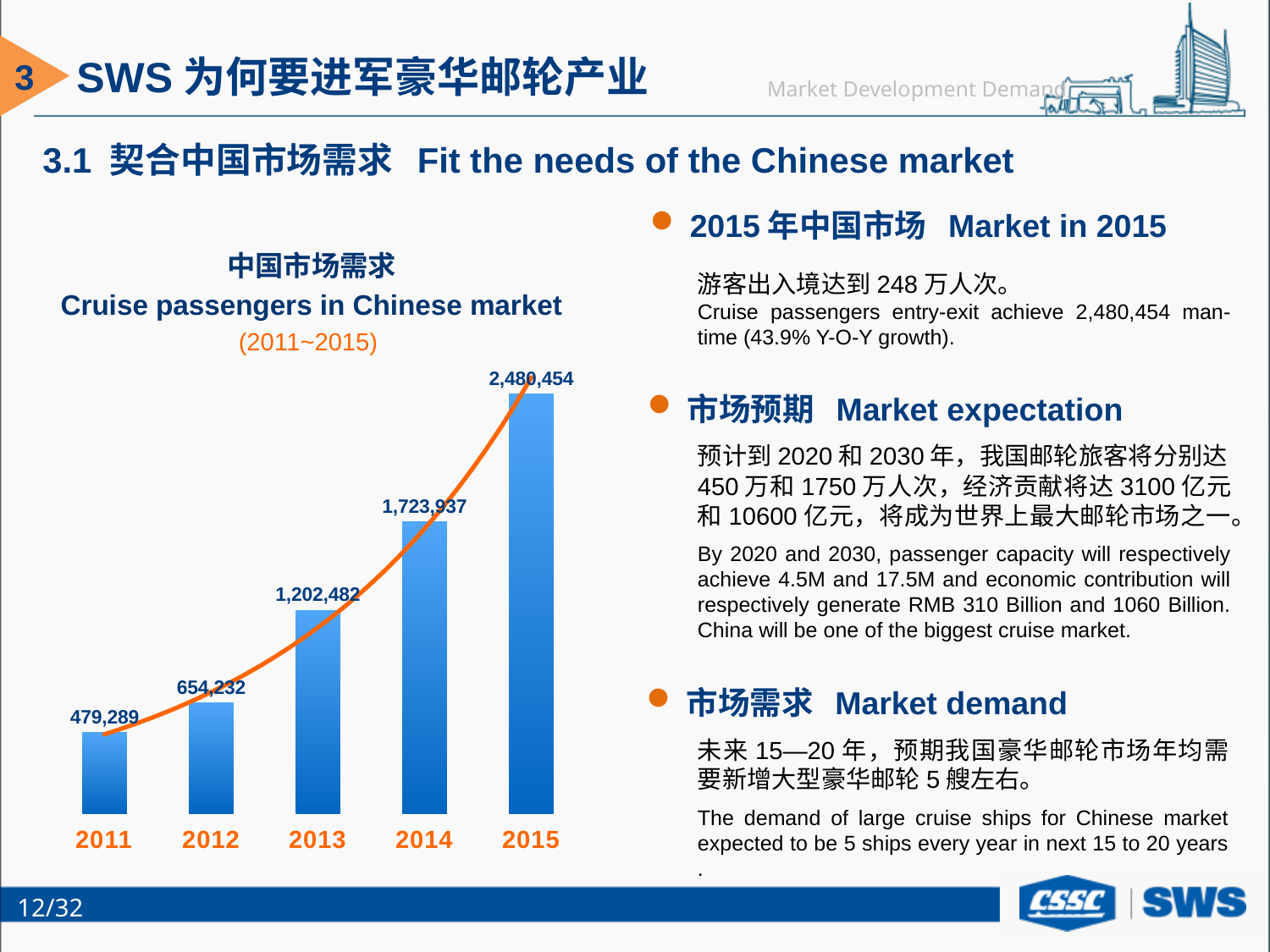
Which year has the lowest value in the Cruise passengers in Chinese market chart? 2011 What is the difference between the 2015 and 2014 values in the Cruise passengers in Chinese market chart? 756,517 What is the difference between the 2012 and 2011 values in the Cruise passengers in Chinese market chart? 174,943 What kind of chart is the Cruise passengers in Chinese market chart? Bar chart Which year has the highest value in the Cruise passengers in Chinese market chart? 2015 What is the value for 2011 in the Cruise passengers in Chinese market chart? 479,289 How many years are shown on the x axis of the Cruise passengers in Chinese market chart? 5 Do the values in the Cruise passengers in Chinese market chart rise or fall from 2011 to 2015? Rise What is the value for 2015 in the Cruise passengers in Chinese market chart? 2,480,454 What is the value for 2013 in the Cruise passengers in Chinese market chart? 1,202,482 What is the value for 2012 in the Cruise passengers in Chinese market chart? 654,232 Which is larger in the Cruise passengers in Chinese market chart, the value for 2013 or the value for 2014? 2014